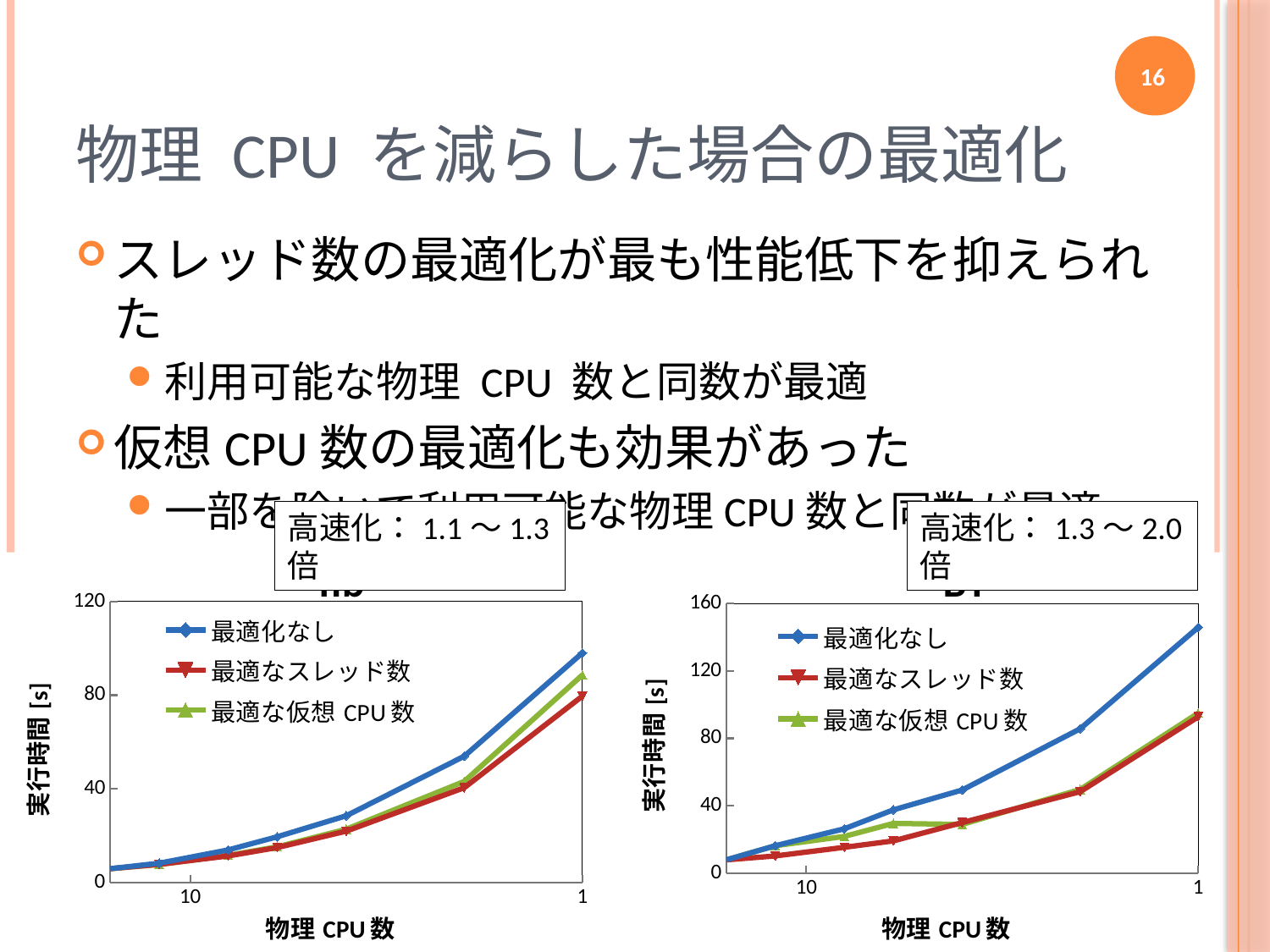
In the right chart, at 物理 CPU 数 = 1, which is larger: 最適化なし or 最適なスレッド数? 最適化なし In the left chart, is the value of 最適な仮想 CPU 数 at 物理 CPU 数 = 1 greater or less than 80? greater In the right chart, is the value of 最適なスレッド数 at 物理 CPU 数 = 1 greater or less than 120? less What are the three series listed in the legend of the left chart? 最適化なし, 最適なスレッド数, 最適な仮想 CPU 数 How many series does the legend of the right chart list? 3 In the left chart, which series has the highest value at 物理 CPU 数 = 1? 最適化なし In the right chart, do the values of 最適化なし rise or fall as the x axis goes from 10 toward 1? rise In the left chart, which series has the lowest value at 物理 CPU 数 = 1? 最適なスレッド数 What kind of chart is the left chart on the slide? line chart In the left chart, is the value of 最適化なし at 物理 CPU 数 = 1 greater or less than 80? greater What is the label of the y axis on the left chart? 実行時間 [s]